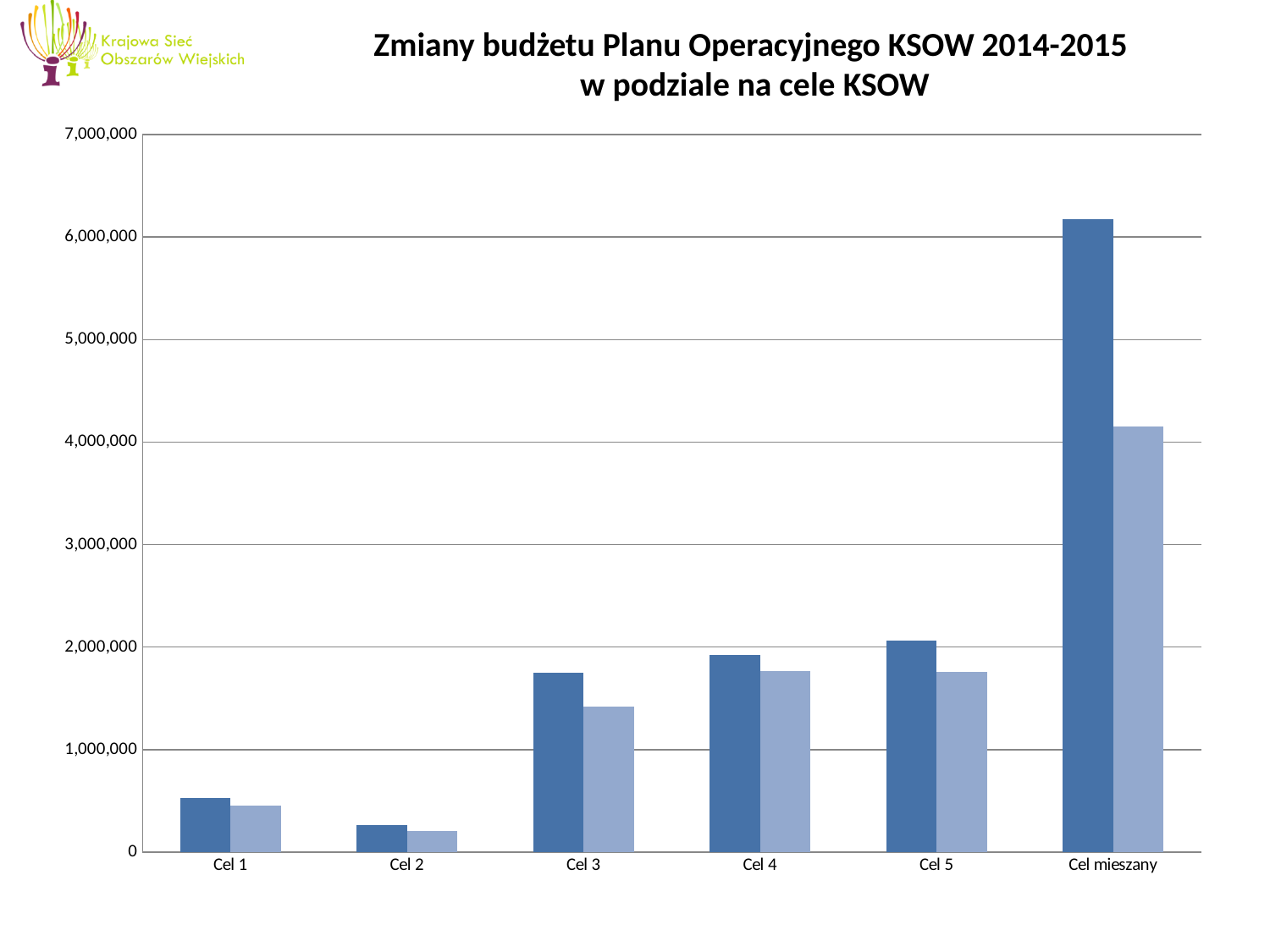
Which category has the lowest dark blue bar? Cel 2 Which is larger, the dark blue bar for Cel 4 or the dark blue bar for Cel 5? Cel 5 What kind of chart is shown on the slide? bar chart What is the title of the chart? Zmiany budżetu Planu Operacyjnego KSOW 2014-2015 w podziale na cele KSOW Is the dark blue bar for Cel mieszany greater or less than 6,000,000? greater Which category has the highest dark blue bar? Cel mieszany Which category has the lowest light blue bar? Cel 2 Is the dark blue bar for Cel 3 greater or less than 2,000,000? less How many categories are shown on the x axis? 6 Which is larger, the dark blue bar for Cel 3 or the dark blue bar for Cel 4? Cel 4 Is the dark blue bar for Cel 1 greater or less than 1,000,000? less